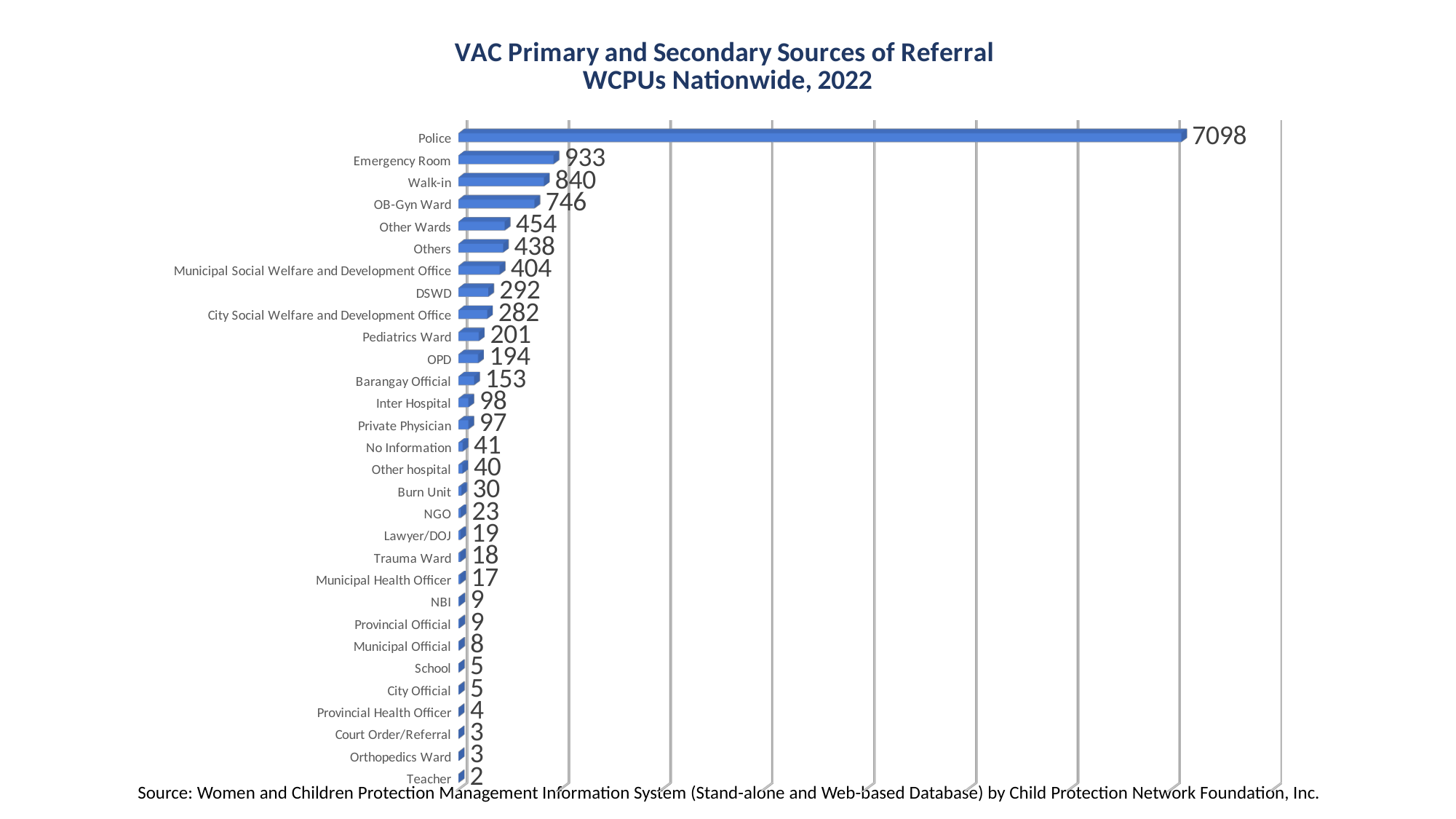
What is the title of the chart? VAC Primary and Secondary Sources of Referral WCPUs Nationwide, 2022 What is the value for Emergency Room? 933 What is the value for DSWD? 292 Which source of referral has the lowest value? Teacher Which is larger, the value for Other Wards or the value for Others? Other Wards What is the value for Police? 7098 What is the value for Barangay Official? 153 What kind of chart is shown on the slide? Bar chart How many sources of referral are shown in the chart? 30 What is the difference between the values for Walk-in and OB-Gyn Ward? 94 What is the difference between the values for Police and Emergency Room? 6165 Which source of referral has the highest value? Police